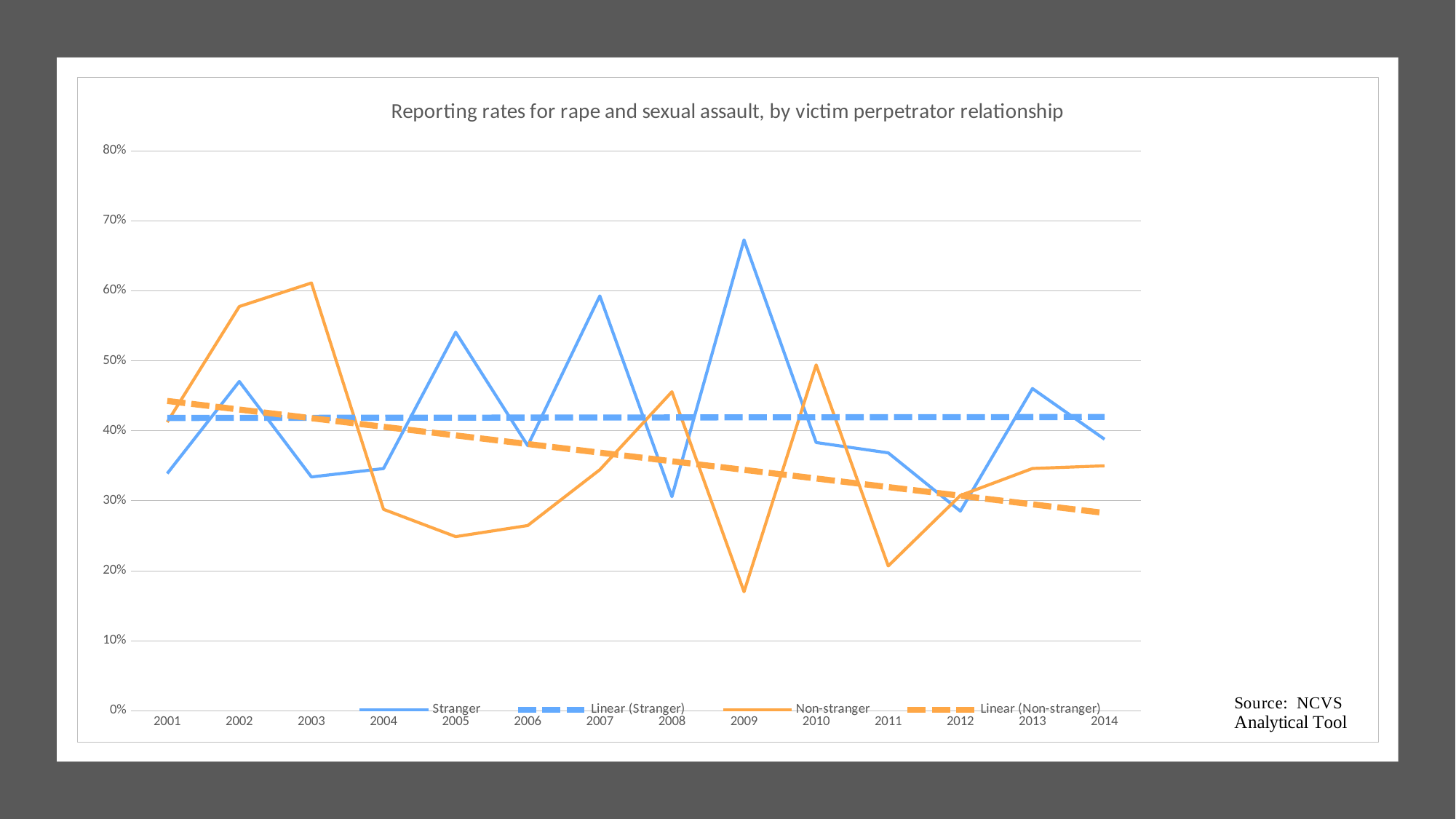
Does the Linear (Non-stranger) trend line rise or fall from 2001 to 2014? fall How many entries does the legend list? 4 What kind of chart is shown on the slide? line chart Is the Non-stranger value for 2009 greater or less than 20%? less In which year does the Non-stranger series reach its lowest value? 2009 What is the title of the chart? Reporting rates for rape and sexual assault, by victim perpetrator relationship In which year does the Stranger series reach its highest value? 2009 In which year does the Stranger series reach its lowest value? 2012 How many years are plotted along the x axis? 14 Is the Stranger value for 2009 greater or less than 60%? greater In 2003, which series has the larger value, Stranger or Non-stranger? Non-stranger In which year does the Non-stranger series reach its highest value? 2003